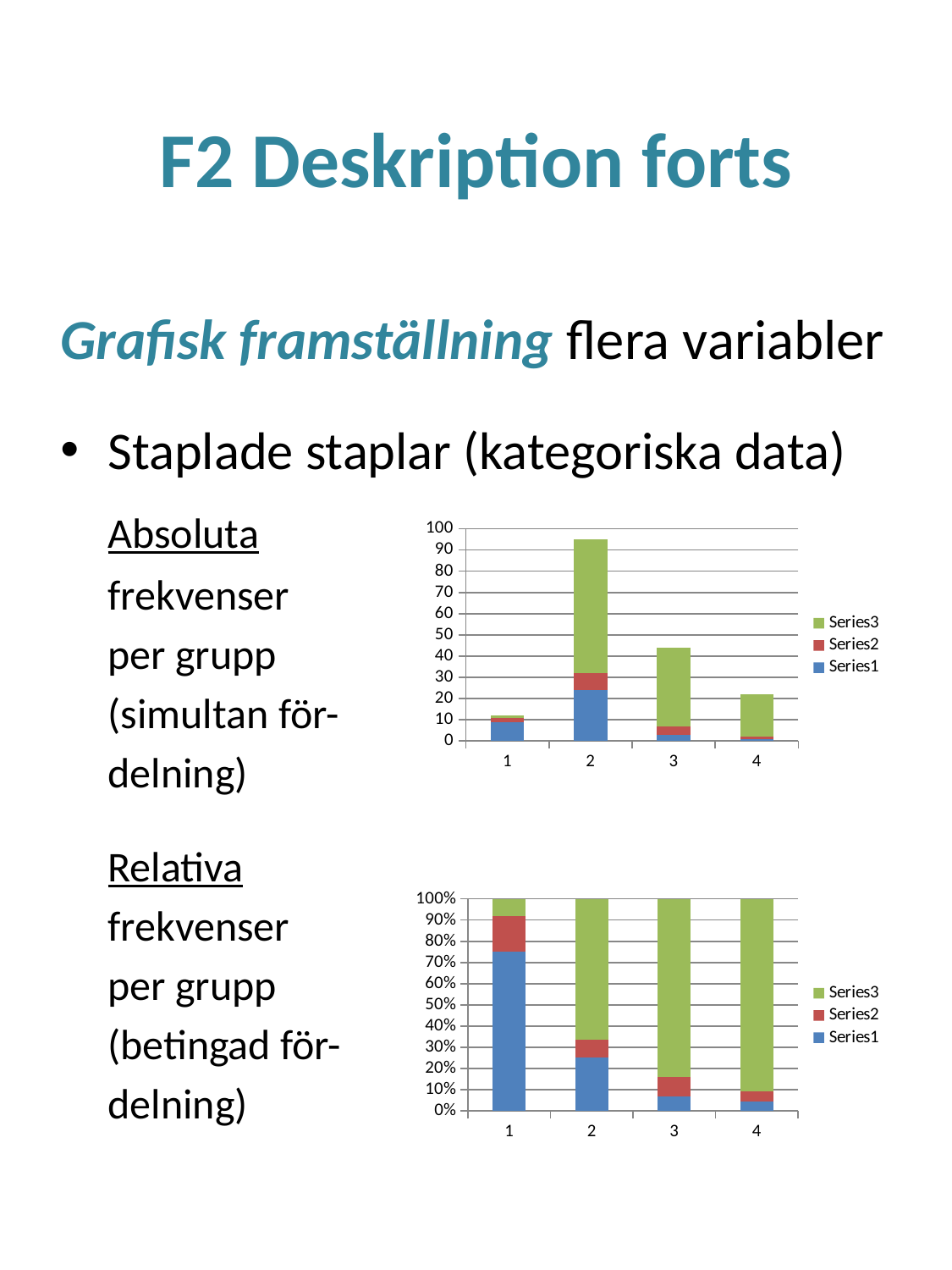
In the top chart, which stacked bar is taller, category 1 or category 3? 3 In the bottom chart, is the Series1 share for category 1 greater or less than 50%? greater In the top chart, which category has the tallest stacked bar? 2 Which series is shown in green in the legend of the bottom chart? Series3 In the top chart, is the total for category 4 greater or less than 30? less In the top chart, which category has the shortest stacked bar? 1 What kind of chart is the top chart (absolute frequencies)? stacked bar chart In the top chart, is the total for category 2 greater or less than 80? greater How many categories are shown on the x axis of the top chart? 4 How many series does the legend of the top chart list? 3 In the bottom chart, does the Series1 share rise or fall from category 1 to category 4? fall What kind of chart is the bottom chart (relative frequencies)? 100% stacked bar chart